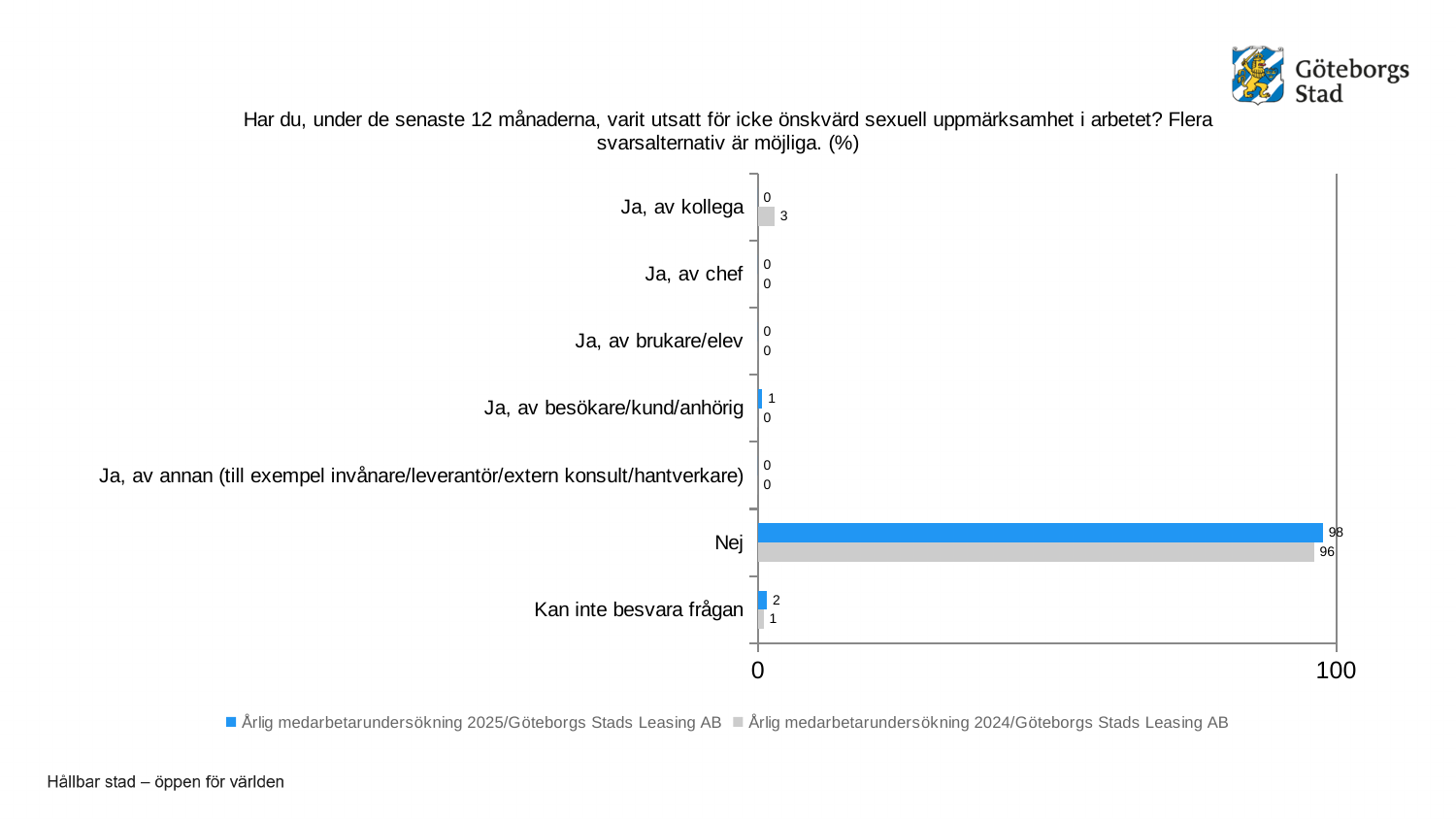
What is the difference between the 2025 and 2024 values for "Nej"? 2 What is the value for "Ja, av besökare/kund/anhörig" in the 2025 series? 1 Which colour represents the Årlig medarbetarundersökning 2025/Göteborgs Stads Leasing AB series? Blue What is the value for "Nej" in the Årlig medarbetarundersökning 2024/Göteborgs Stads Leasing AB series? 96 What is the value for "Ja, av kollega" in the 2024 series? 3 How many series does the legend list? 2 What is the value for "Kan inte besvara frågan" in the 2025 series? 2 How many categories are shown on the chart? 7 Which is larger for "Ja, av kollega": the 2025 value or the 2024 value? The 2024 value What is the value for "Nej" in the Årlig medarbetarundersökning 2025/Göteborgs Stads Leasing AB series? 98 What kind of chart is shown on the slide? Bar chart Which category has the highest value in the 2025 series? Nej